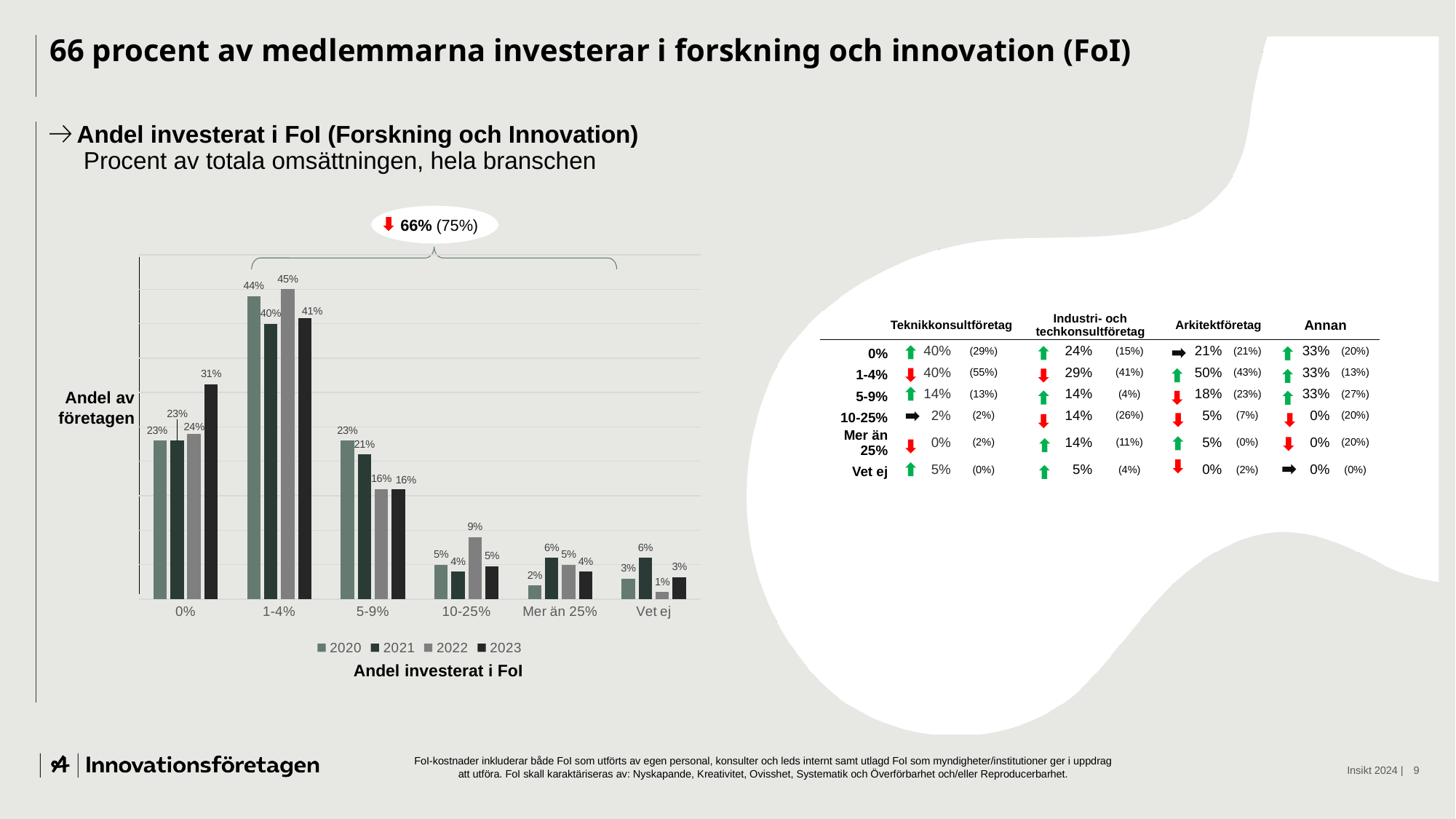
Which category has the lowest value for the 2020 series? Mer än 25% What kind of chart is shown on the slide? Bar chart What is the difference between the 2023 and 2020 values in the 0% category? 8% What is the value for 2022 in the 1-4% category? 45% What is the value for 2023 in the 0% category? 31% What is the value for 2022 in the Vet ej category? 1% What is the value for 2021 in the 5-9% category? 21% Which is larger in the 5-9% category: the 2020 value or the 2023 value? 2020 What is the value for 2022 in the 10-25% category? 9% How many series does the legend list? 4 Which category has the highest value for the 2023 series? 1-4% How many categories are shown on the x axis? 6